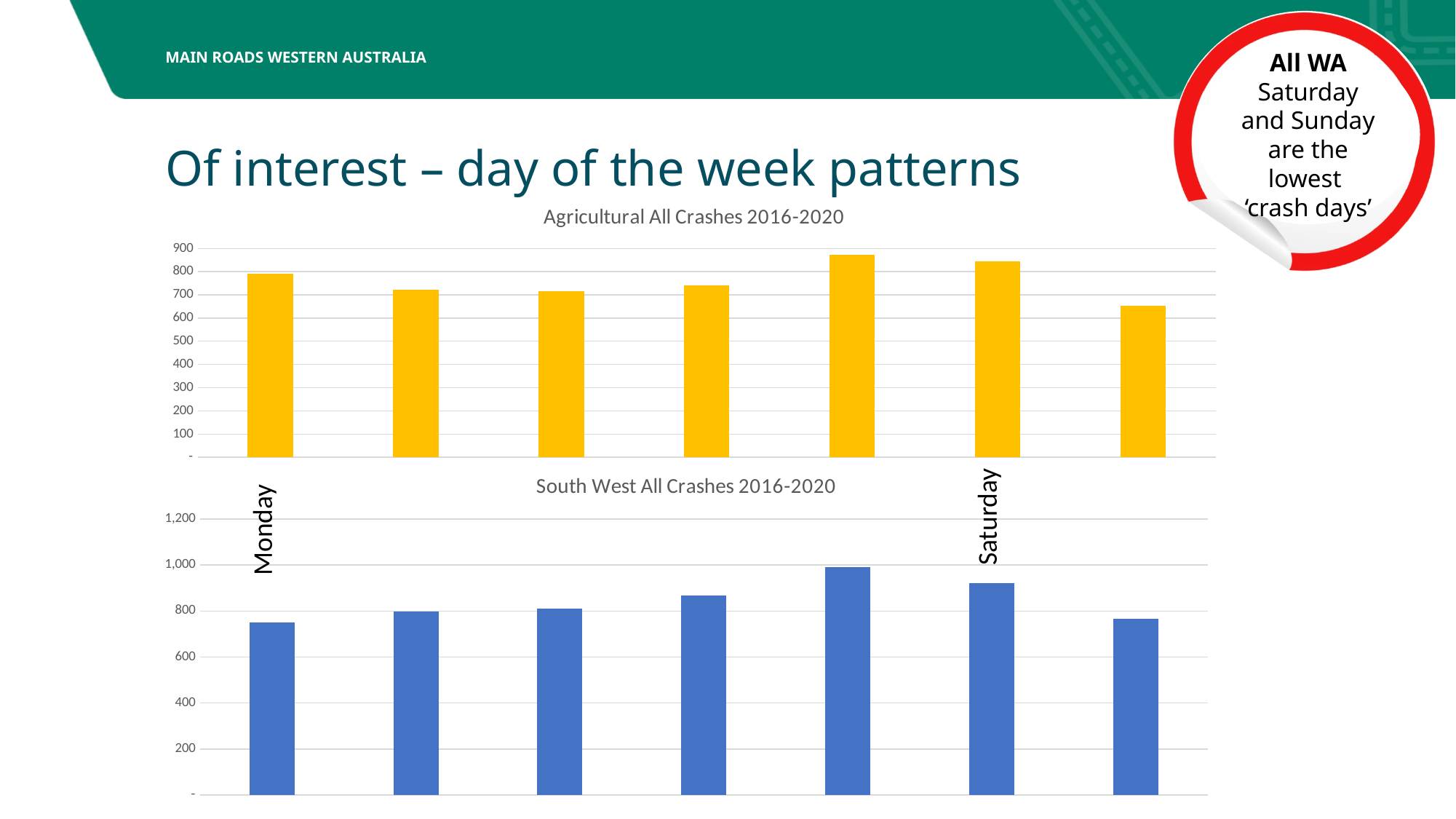
In the 'Agricultural All Crashes 2016-2020' chart, is the value for Saturday greater or less than 800? greater In the 'Agricultural All Crashes 2016-2020' chart, which has the larger value, Monday or Saturday? Saturday In the 'South West All Crashes 2016-2020' chart, is the value for Monday greater or less than 800? less How many bars are plotted in the 'South West All Crashes 2016-2020' chart? 7 In the 'South West All Crashes 2016-2020' chart, which has the larger value, Monday or Saturday? Saturday In the 'Agricultural All Crashes 2016-2020' chart, is the value for Monday greater or less than 700? greater How many bars are plotted in the 'Agricultural All Crashes 2016-2020' chart? 7 What colour are the bars in the 'South West All Crashes 2016-2020' chart? blue What type of chart is the 'Agricultural All Crashes 2016-2020' chart? bar chart What is the title of the top chart on the slide? Agricultural All Crashes 2016-2020